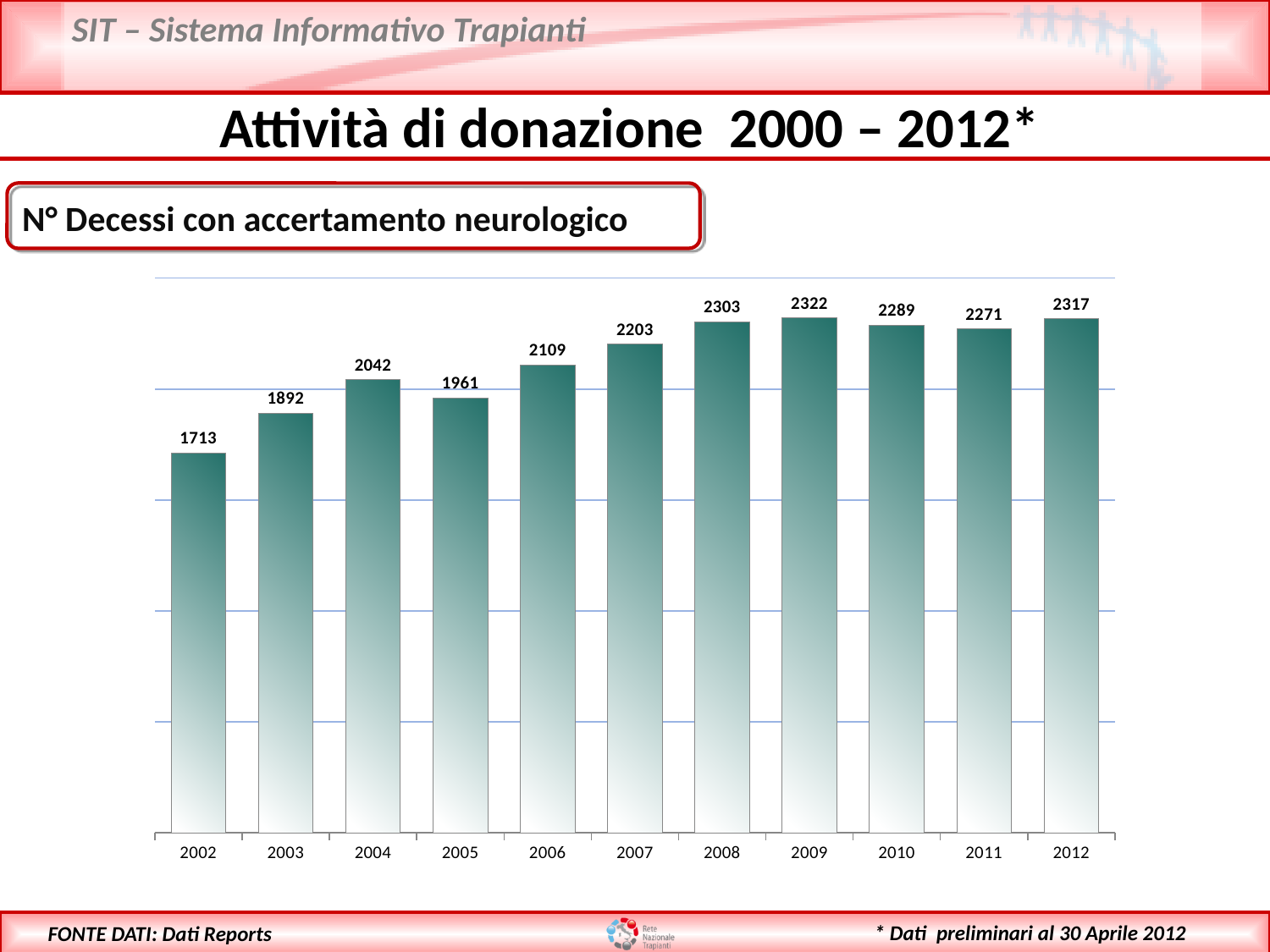
What is the value for 2005? 1961 Do the values generally rise or fall from 2002 to 2009? rise Which year has the highest value? 2009 What is the value for 2007? 2203 Which is larger, the value for 2004 or the value for 2005? 2004 Which year has the lowest value? 2002 What is the difference between the values for 2012 and 2002? 604 What is the value for 2012? 2317 What type of chart is shown on the slide? bar chart What is the value for 2002? 1713 How many years are shown on the x axis? 11 What is the title shown in the box above the chart? N° Decessi con accertamento neurologico